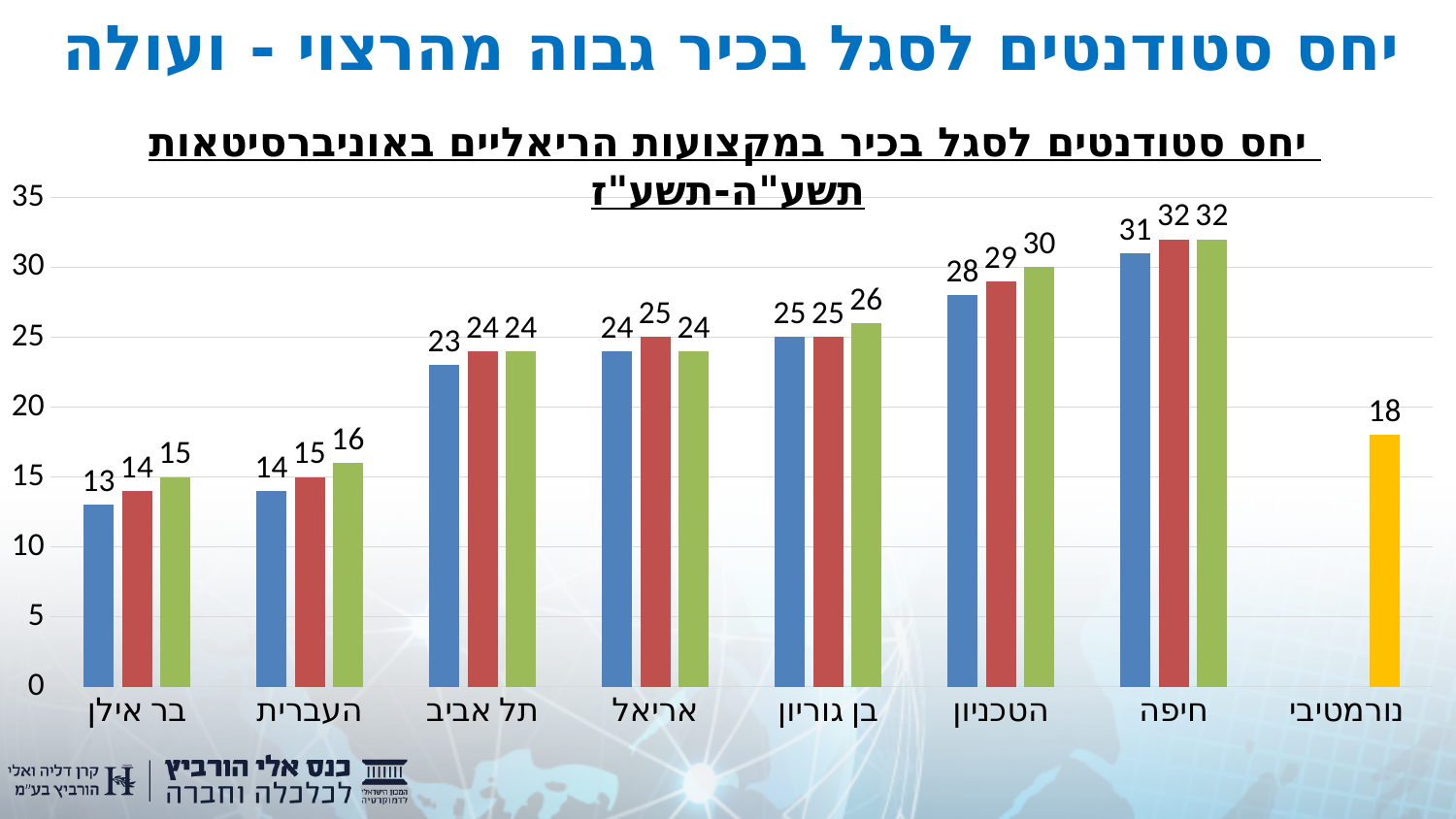
What is the difference between the green bar for חיפה (Haifa) and the green bar for העברית (Hebrew University)? 16 What is the value of the blue bar for בר אילן (Bar Ilan)? 13 Which university has the lowest blue bar value? בר אילן What is the value of the yellow bar for נורמטיבי (normative)? 18 Is the red bar for הטכניון (Technion) greater or less than 25? greater How many categories are shown on the x axis? 8 Which university has the highest values across all three bars? חיפה Which is larger: the green bar for בן גוריון (Ben Gurion) or the green bar for תל אביב (Tel Aviv)? בן גוריון What is the value of the red bar for אריאל (Ariel)? 25 What type of chart is shown on the slide? bar chart What is the value of the green bar for הטכניון (Technion)? 30 Do the values for בר אילן (Bar Ilan) rise or fall from the blue bar to the green bar? rise